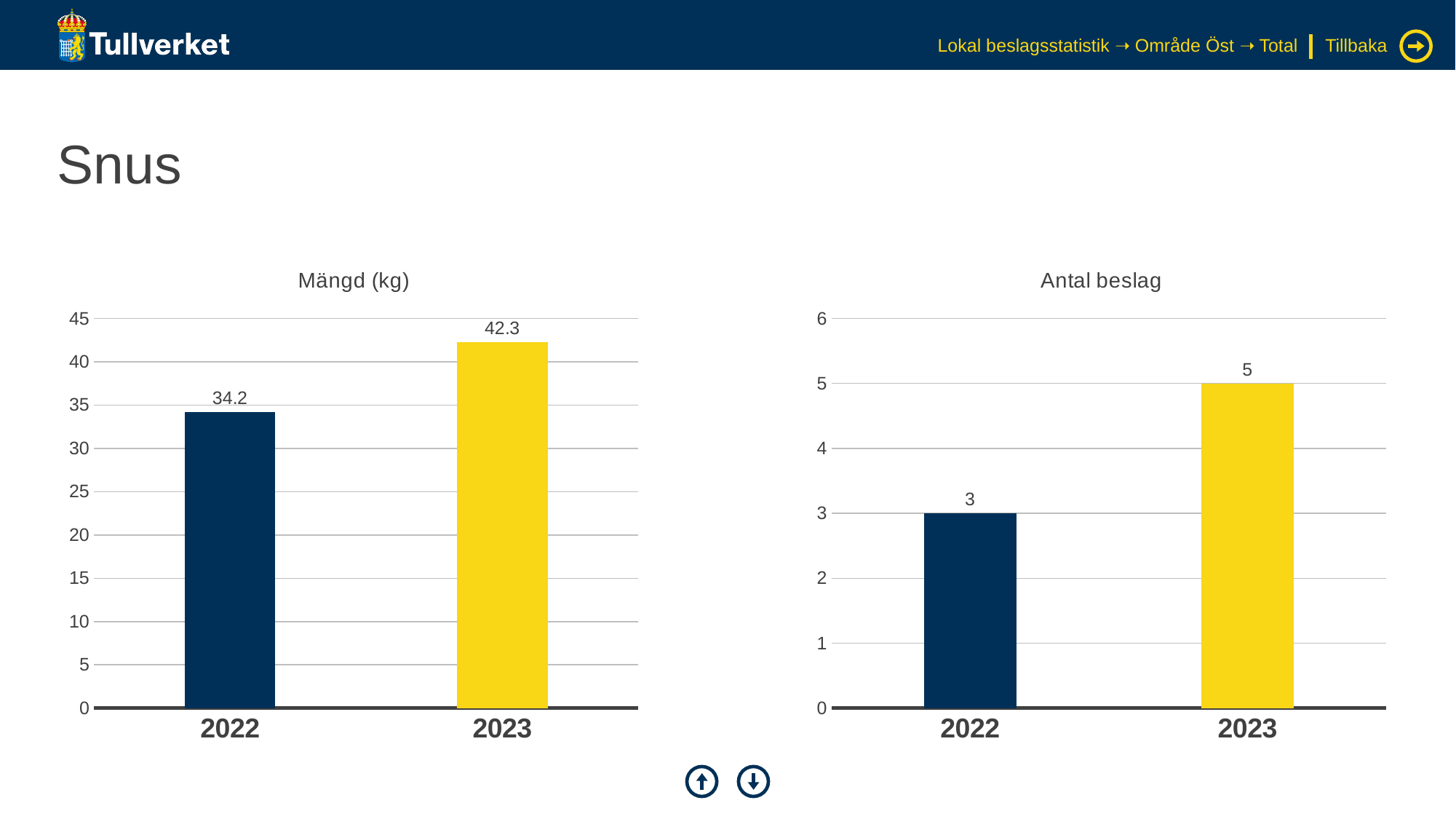
In the 'Antal beslag' chart, how many years are shown on the x axis? 2 In the 'Antal beslag' chart, which year has the lowest value? 2022 In the 'Mängd (kg)' chart, what is the value for 2022? 34.2 In the 'Antal beslag' chart, what is the difference between the 2023 and 2022 values? 2 In the 'Mängd (kg)' chart, what is the difference between the 2023 and 2022 values? 8.1 In the 'Mängd (kg)' chart, is the value for 2022 greater or less than 30? greater In the 'Mängd (kg)' chart, what is the value for 2023? 42.3 In the 'Antal beslag' chart, what is the value for 2022? 3 What kind of chart is the 'Mängd (kg)' chart? Bar chart In the 'Mängd (kg)' chart, which year has the highest value? 2023 In the 'Antal beslag' chart, what is the value for 2023? 5 In the 'Antal beslag' chart, do the values rise or fall from 2022 to 2023? Rise